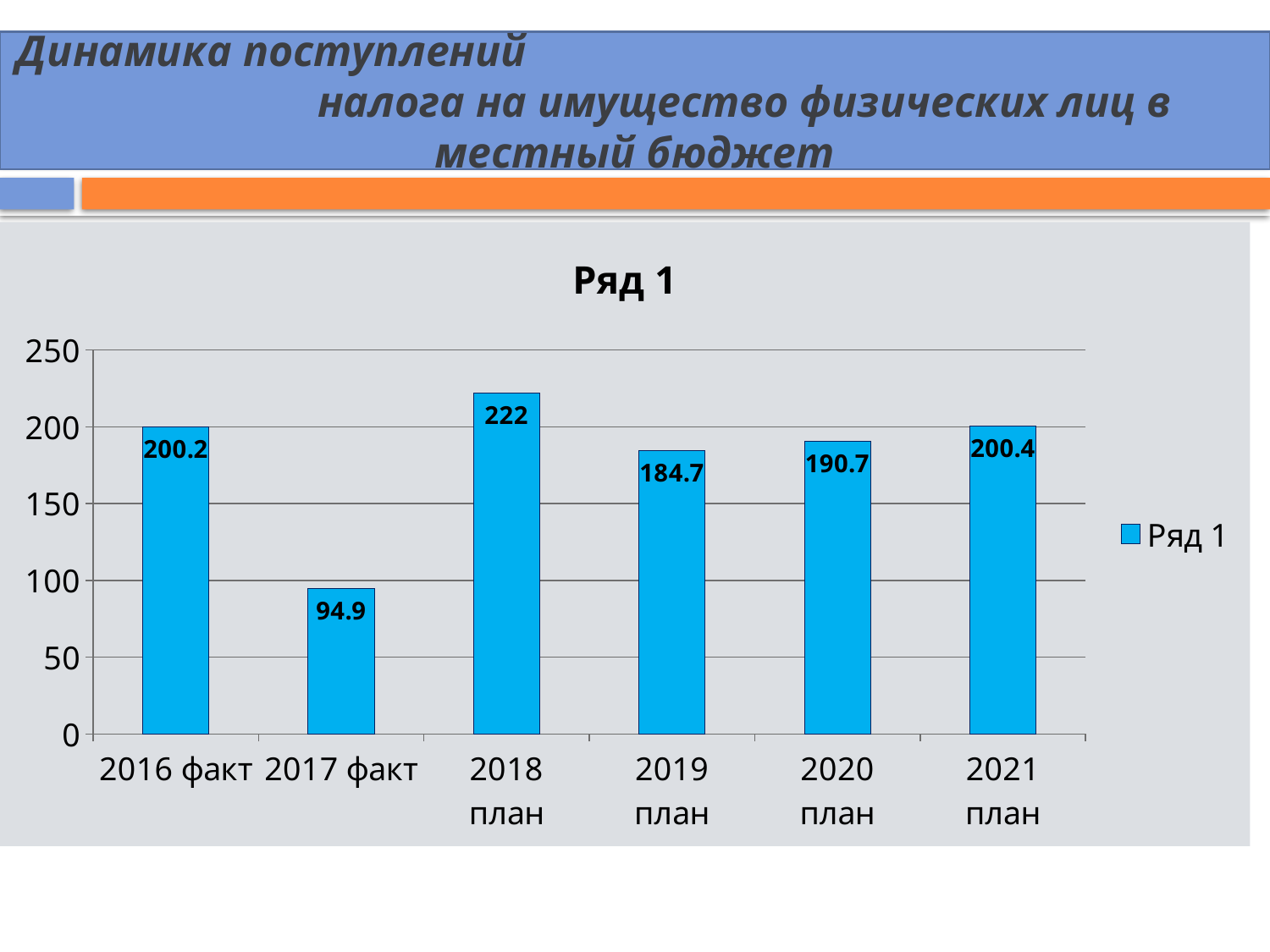
What is the value for 2016 факт? 200.2 Which category has the highest value? 2018 план How many categories are shown on the x axis? 6 What is the title of the chart? Ряд 1 Is the value for 2021 план greater or less than 150? greater How many series does the legend list? 1 Which category has the lowest value? 2017 факт What is the difference between the values for 2018 план and 2017 факт? 127.1 What is the value for 2019 план? 184.7 What is the value for 2017 факт? 94.9 Which is larger, the value for 2020 план or the value for 2019 план? 2020 план What kind of chart is shown on the slide? bar chart